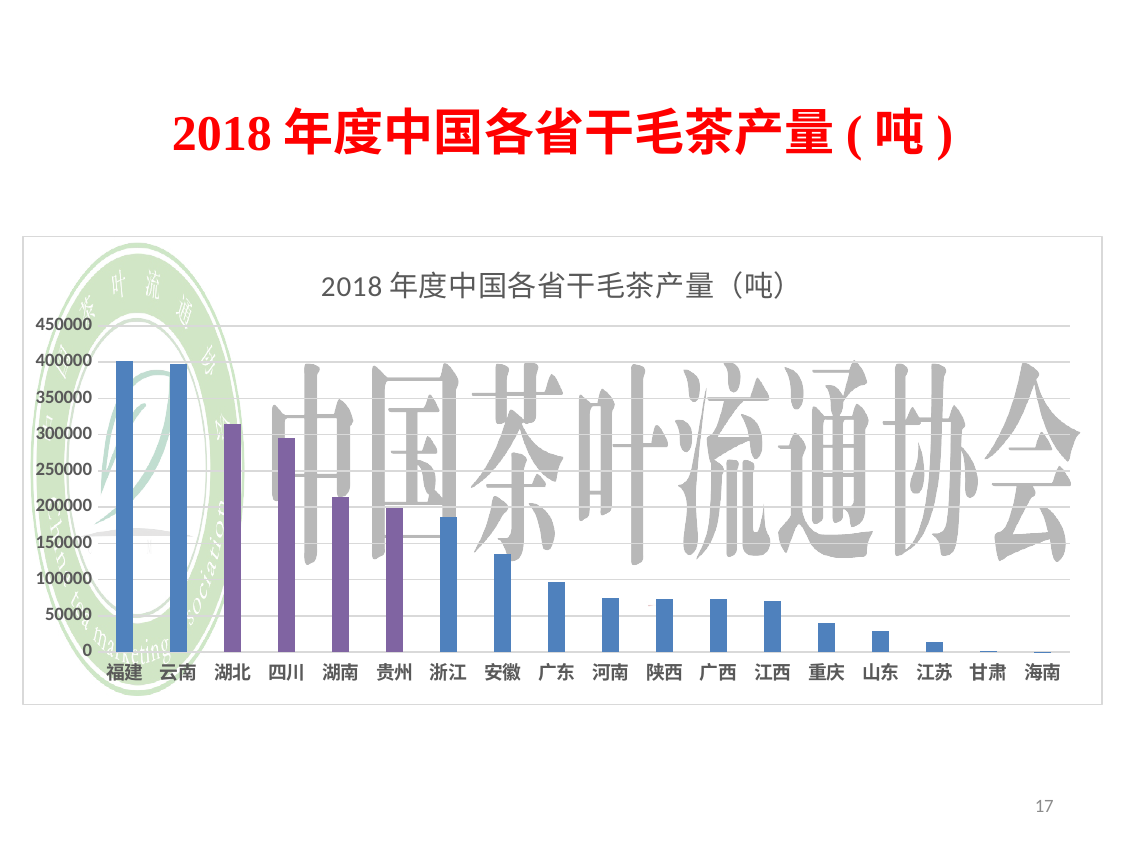
How many bars in the chart are coloured purple rather than blue? 4 Is the value for 安徽 greater or less than 150000? less Is the value for 湖南 greater or less than 200000? greater Is the value for 重庆 greater or less than 50000? less What kind of chart is shown on the slide? Bar chart Do the values generally rise or fall moving from left to right along the x axis? Fall Which has the larger value, 安徽 or 广东? 安徽 How many provinces are shown on the x axis of the chart? 18 Which has the larger value, 湖北 or 四川? 湖北